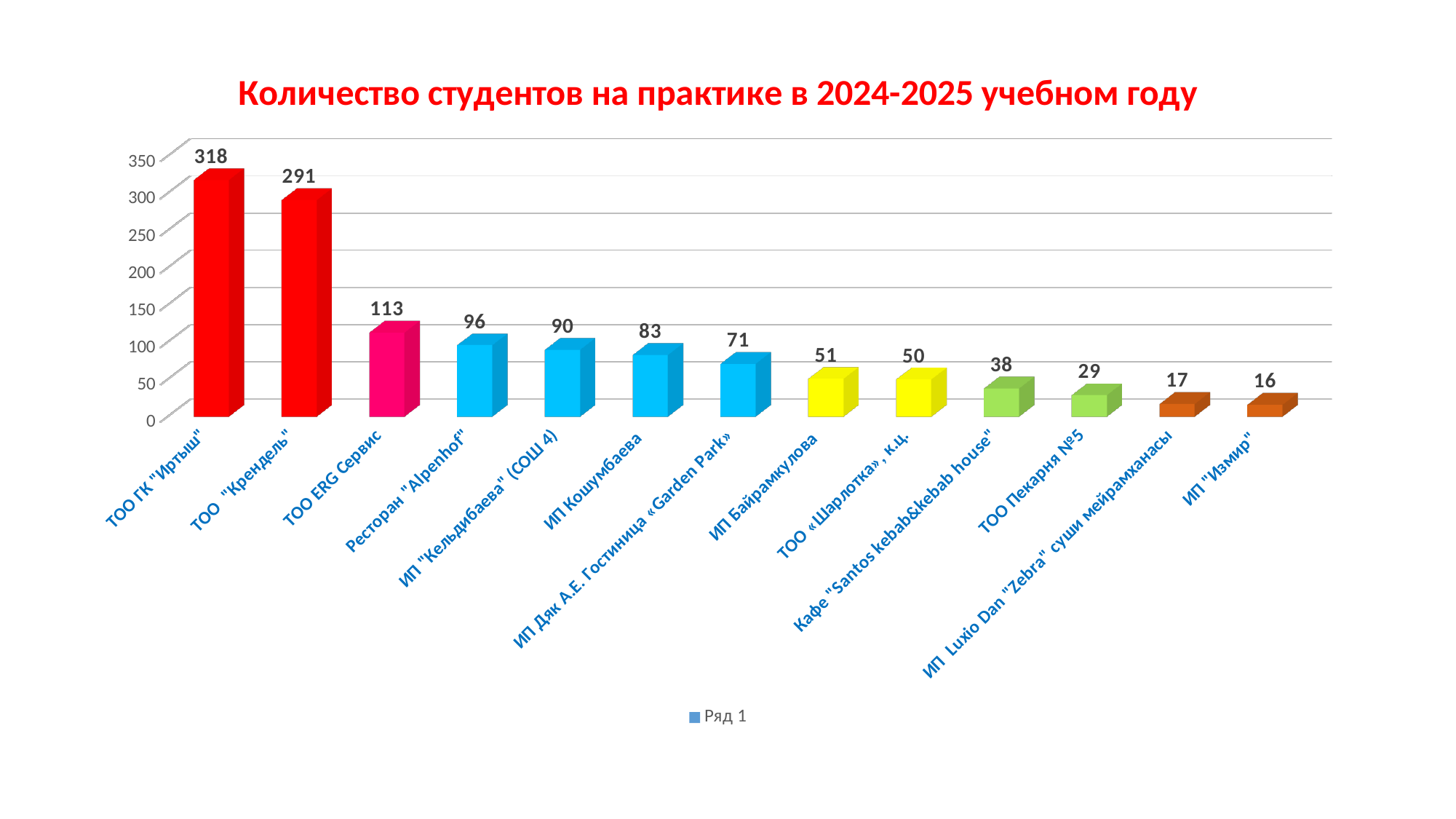
How many categories are shown on the chart? 13 Is the value for ТОО Пекарня №5 greater or less than 50? less How many series does the legend list? 1 What is the title of the chart? Количество студентов на практике в 2024-2025 учебном году What is the difference between the values for ТОО ГК "Иртыш" and ТОО "Крендель"? 27 Which is larger, the value for Ресторан "Alpenhof" or the value for ИП "Кельдибаева" (СОШ 4)? Ресторан "Alpenhof" Which category has the highest value? ТОО ГК "Иртыш" What is the value for ТОО ERG Сервис? 113 What is the value for ТОО ГК "Иртыш"? 318 Which category has the lowest value? ИП "Измир" What kind of chart is shown on the slide? bar chart What is the value for ИП Кошумбаева? 83